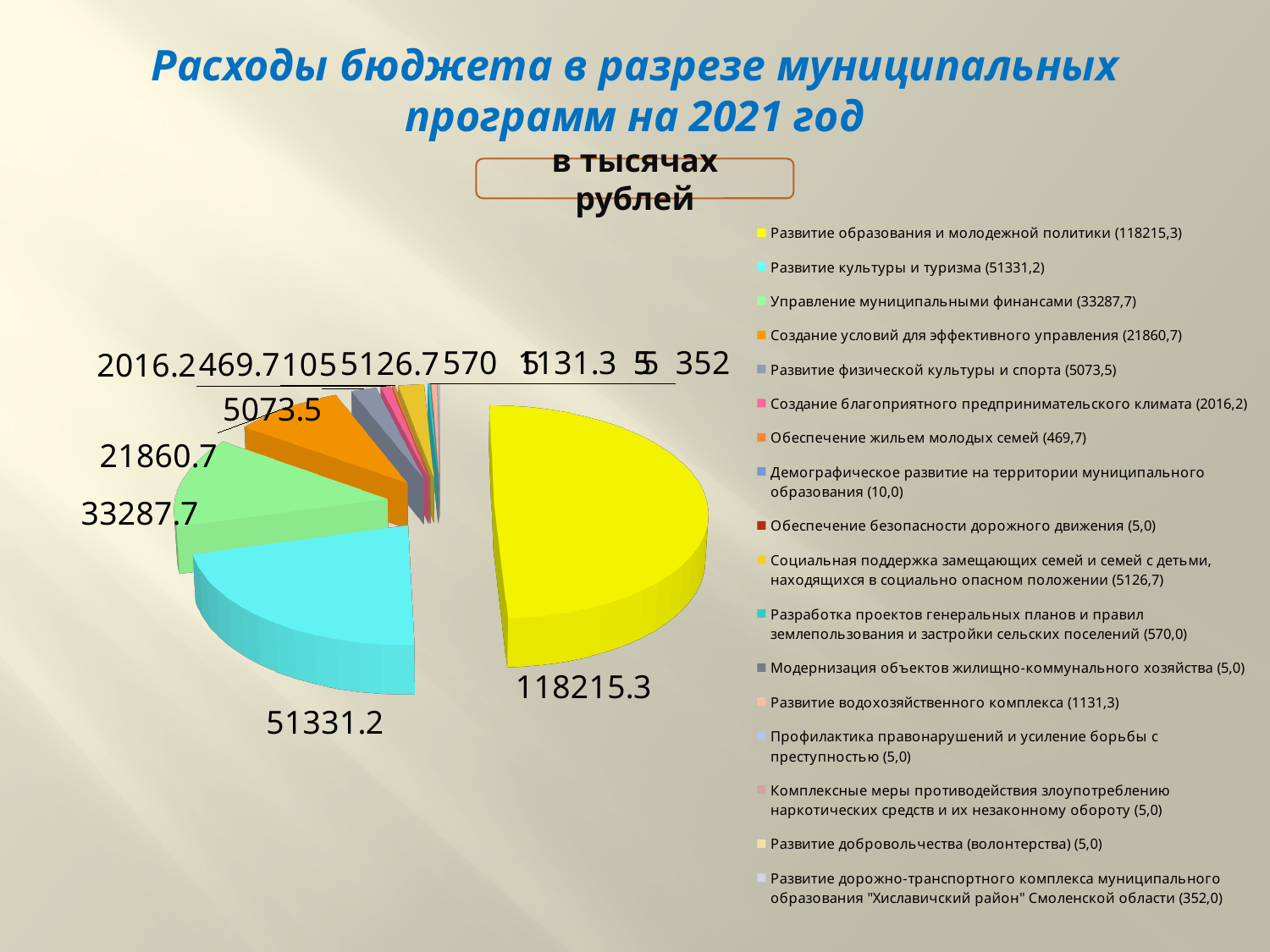
How many programs are listed in the legend? 17 In what units are the values on the chart expressed, according to the slide? в тысячах рублей Which program has the largest slice of the pie? Развитие образования и молодежной политики What is the value for Развитие физической культуры и спорта? 5073.5 What is the value for Управление муниципальными финансами? 33287.7 What is the value for Создание условий для эффективного управления? 21860.7 Which is larger: Развитие культуры и туризма or Управление муниципальными финансами? Развитие культуры и туризма What is the value for Развитие культуры и туризма? 51331.2 What type of chart is shown on the slide? pie chart What is the difference between Развитие культуры и туризма and Управление муниципальными финансами? 18043.5 What is the value for Развитие образования и молодежной политики? 118215.3 What is the difference between Развитие образования и молодежной политики and Развитие культуры и туризма? 66884.1